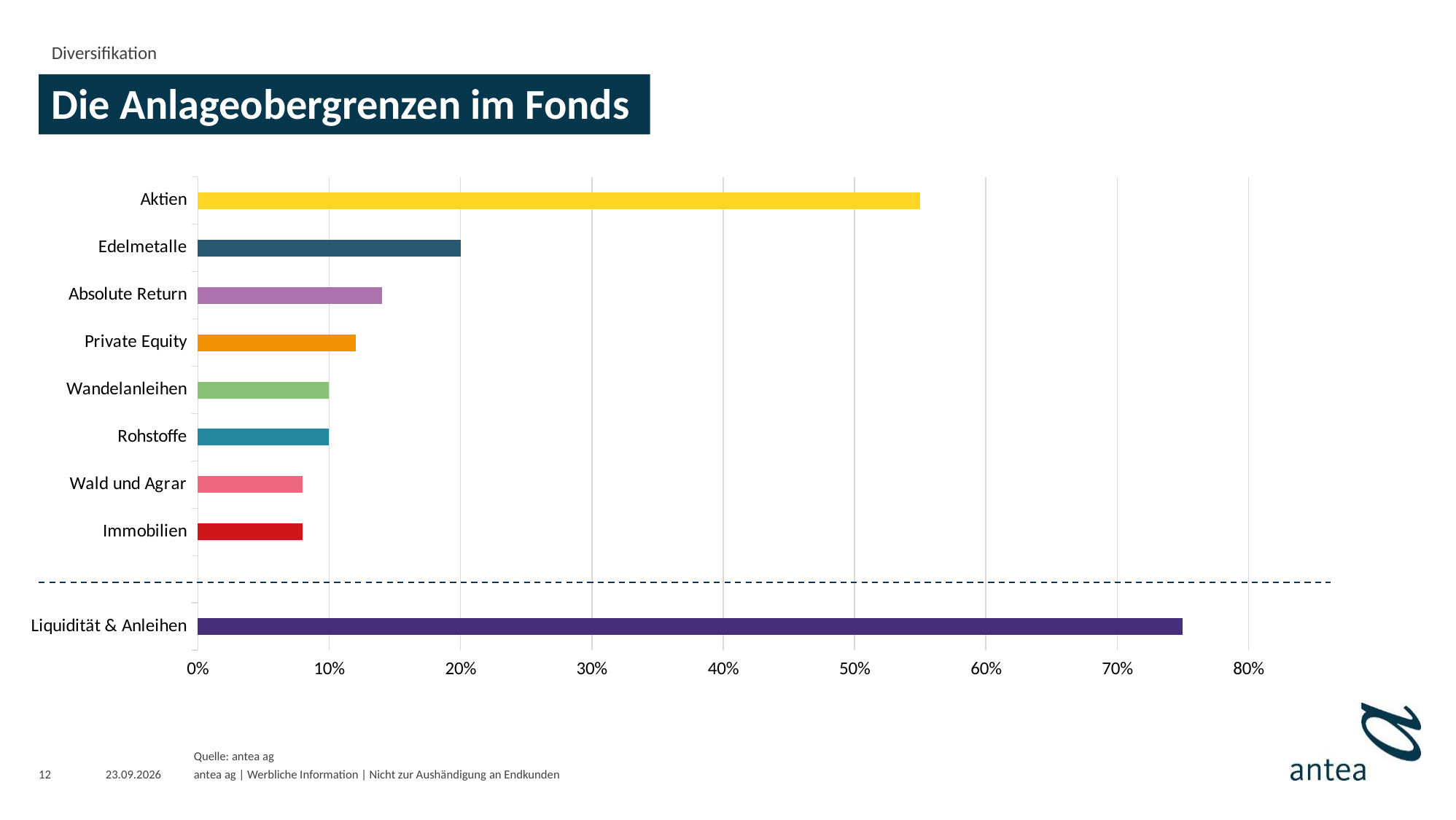
Which category has the highest value in the chart? Liquidität & Anleihen What is the value for Rohstoffe? 10% What is the value for Edelmetalle? 20% Is the value for Aktien greater or less than 50%? greater What is the value for Wandelanleihen? 10% Is the value for Liquidität & Anleihen greater or less than 70%? greater What kind of chart is shown on the slide? bar chart Is the value for Immobilien greater or less than 10%? less What is the title of the chart on the slide? Die Anlageobergrenzen im Fonds Which is larger, the value for Aktien or the value for Edelmetalle? Aktien How many categories are plotted in the chart? 9